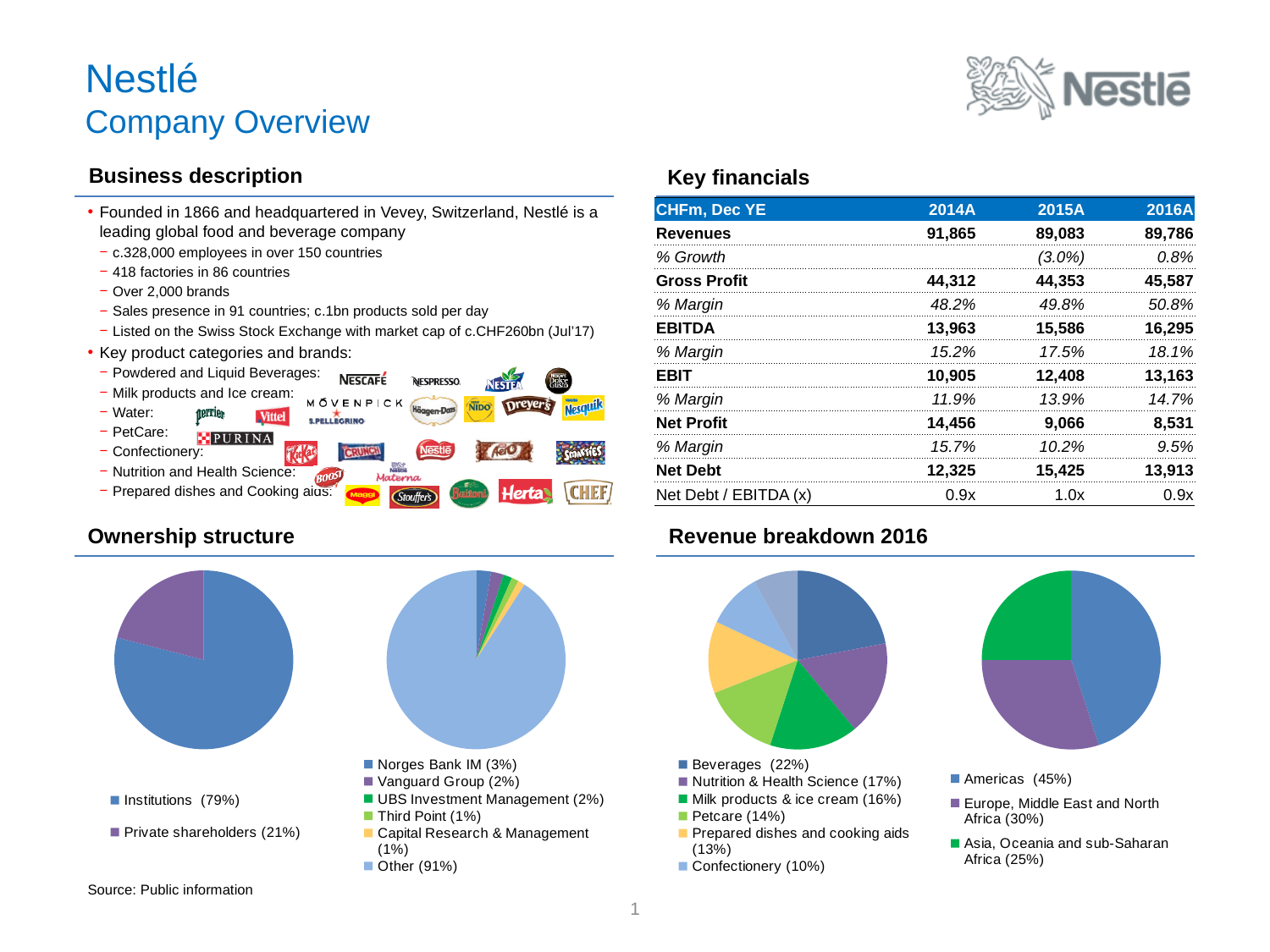
In the Ownership structure chart on the left, what share is held by Private shareholders? 21% In the Revenue breakdown 2016 pie by region, what share comes from Americas? 45% In the Revenue breakdown 2016 pie by product category, which is larger: Nutrition & Health Science or Milk products & ice cream? Nutrition & Health Science In the second Ownership structure pie (institutional breakdown), which named holder has the largest share apart from Other? Norges Bank IM In the Revenue breakdown 2016 pie by region, how many regions are shown? 3 In the Revenue breakdown 2016 pie by product category, what share comes from Beverages? 22% In the Ownership structure chart on the left, what share is held by Institutions? 79% How many slices does the second Ownership structure pie (institutional breakdown) have? 6 In the Revenue breakdown 2016 pie by product category, what is the difference between the Beverages share and the Petcare share? 8 percentage points What type of chart is used for the Revenue breakdown 2016? Pie chart In the second Ownership structure pie (institutional breakdown), what share does Norges Bank IM hold? 3%